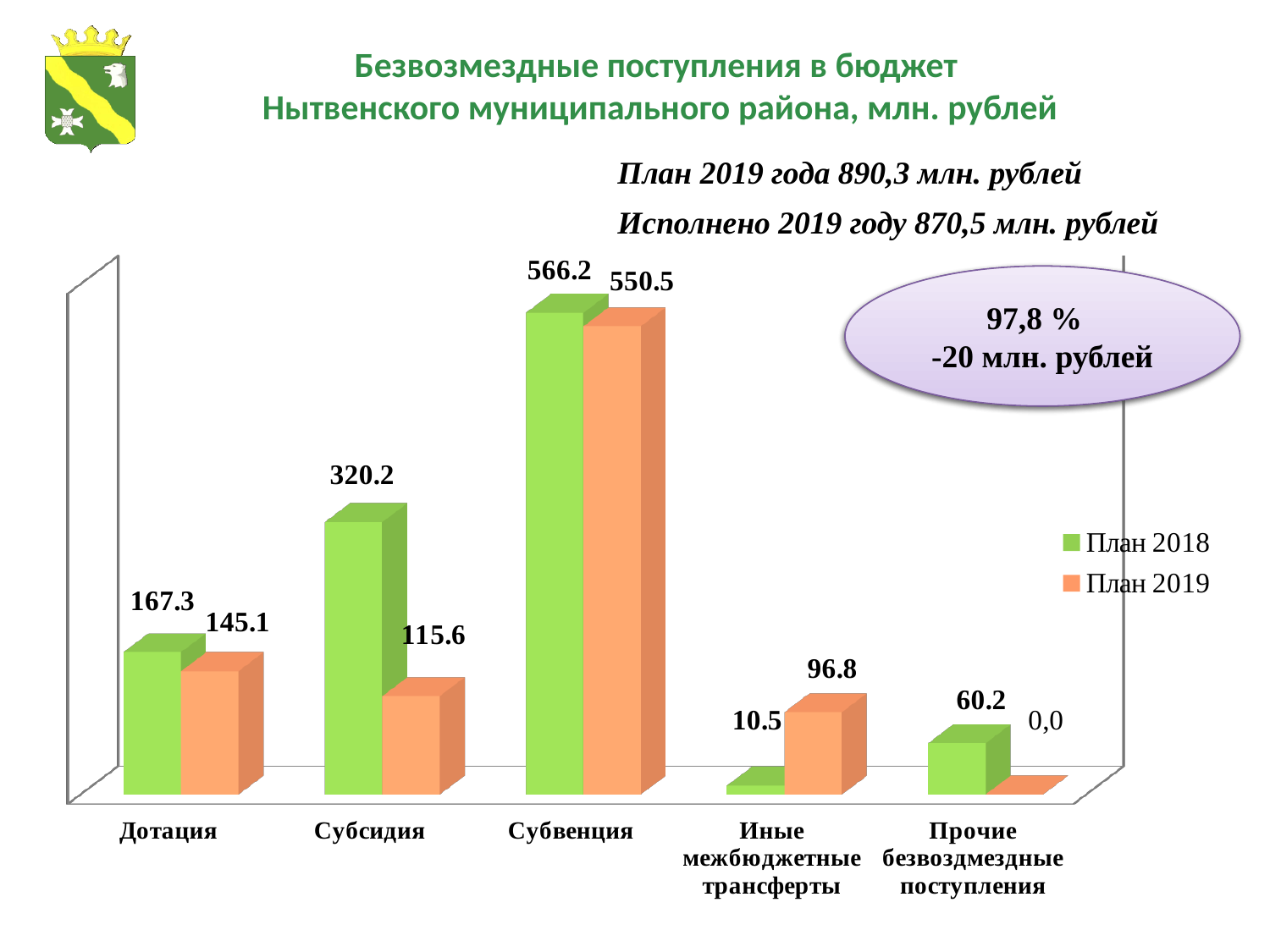
What is the value for Иные межбюджетные трансферты in the План 2019 series? 96.8 What is the value for Прочие безвоздмездные поступления in the План 2019 series? 0,0 How many series does the legend list? 2 For Иные межбюджетные трансферты, which series has the larger value, План 2018 or План 2019? План 2019 What is the difference between the План 2018 and План 2019 values for Субвенция? 15.7 What is the difference between the План 2018 and План 2019 values for Субсидия? 204.6 Which category has the highest value in the План 2018 series? Субвенция How many categories are shown on the x axis of the chart? 5 What is the value for Дотация in the План 2019 series? 145.1 What is the value for Субсидия in the План 2018 series? 320.2 Which category has the lowest value in the План 2018 series? Иные межбюджетные трансферты What kind of chart is shown on the slide? Bar chart